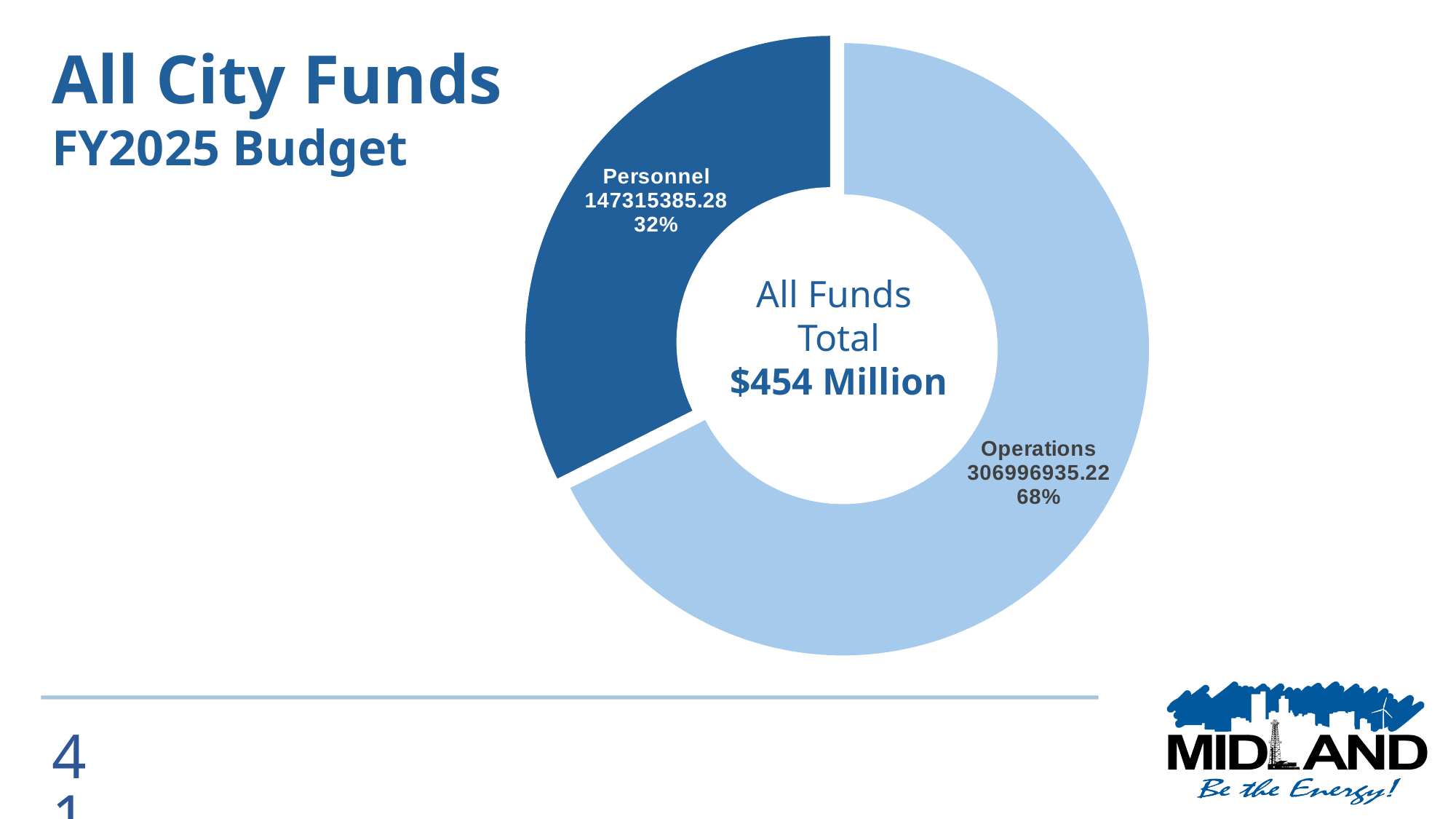
What total is printed in the centre of the chart? $454 Million Which category has the largest slice? Operations Which category has the smallest slice? Personnel What kind of chart is shown on the slide? Pie chart (doughnut) What percentage share of the chart does Operations represent? 68% What is the value shown for Operations? 306996935.22 What is the difference between the Operations value and the Personnel value? 159681549.94 Which category is shown in the darker blue colour? Personnel What percentage share of the chart does Personnel represent? 32% What is the value shown for Personnel? 147315385.28 Which is larger, Personnel or Operations? Operations How many categories are shown in the chart? 2